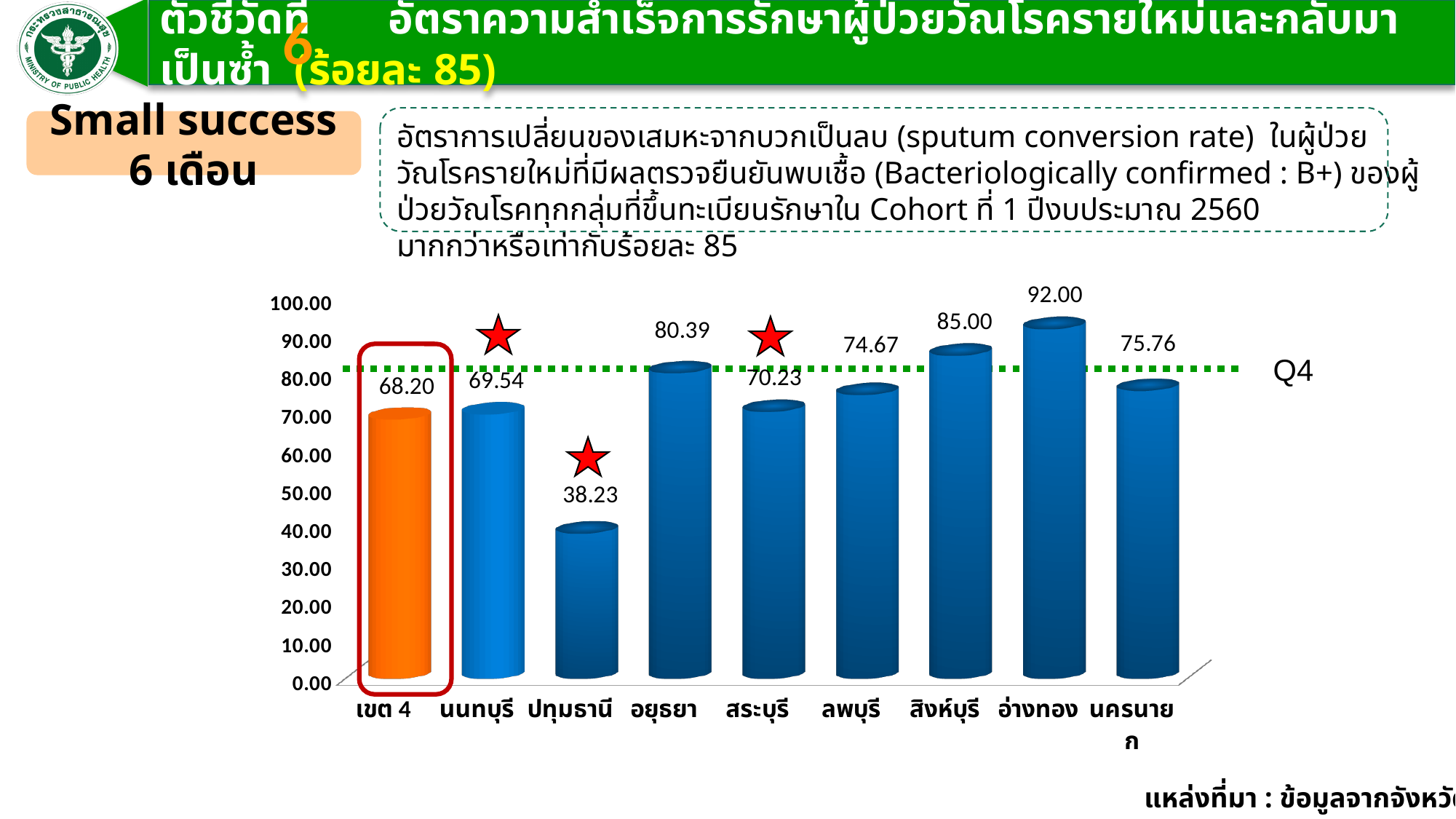
What is the difference between the values for สิงห์บุรี and เขต 4? 16.80 What kind of chart is shown on the slide? bar chart Which category has the highest value? อ่างทอง What is the value for สิงห์บุรี? 85.00 What is the value for ปทุมธานี? 38.23 Which is larger, the value for อยุธยา or the value for นครนายก? อยุธยา How many categories are shown on the x axis? 9 What is the value for อ่างทอง? 92.00 What is the difference between the values for อ่างทอง and ปทุมธานี? 53.77 What label is shown next to the green dotted horizontal line on the chart? Q4 Which category has the lowest value? ปทุมธานี What is the value for เขต 4? 68.20